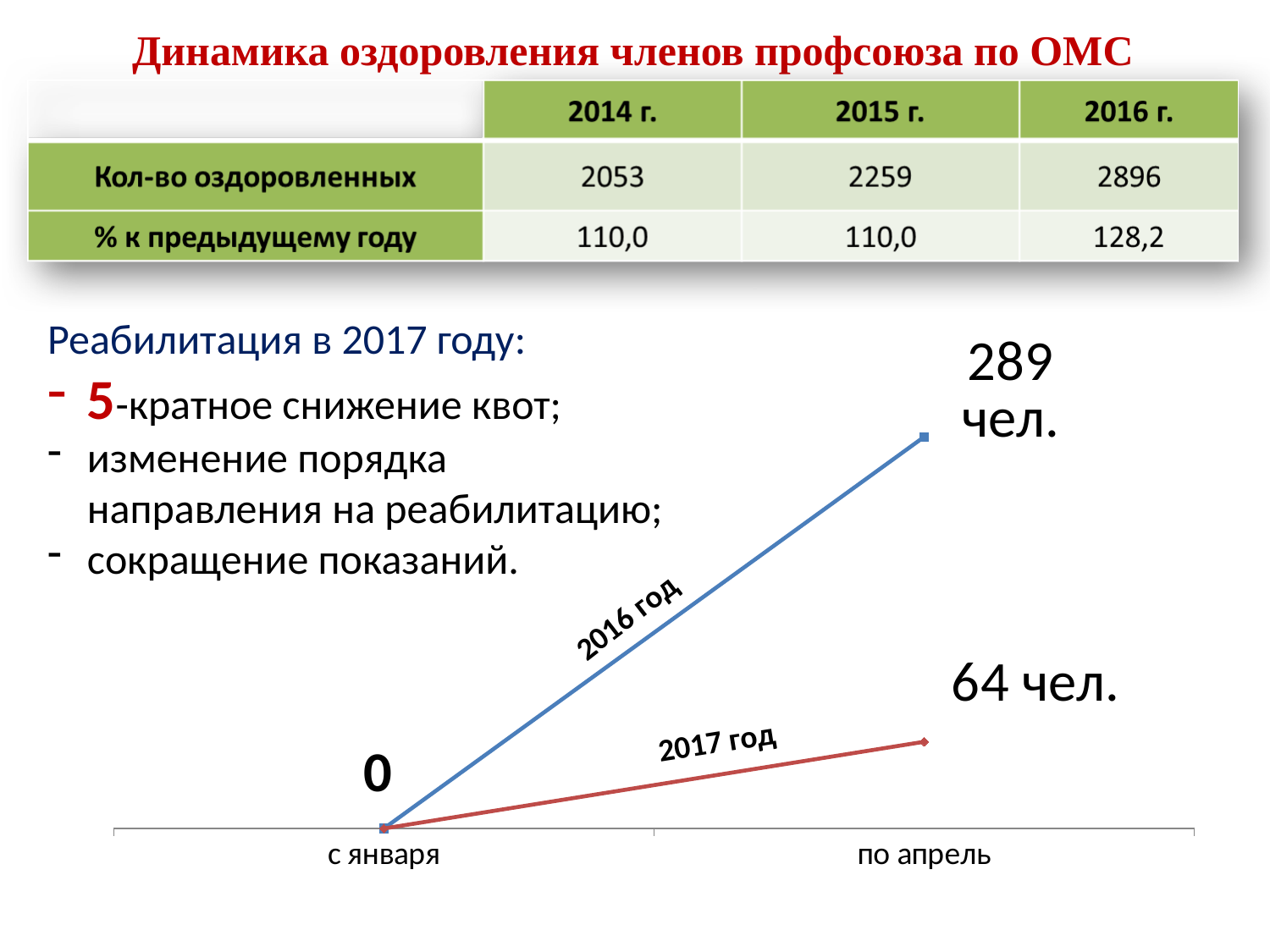
What are the two x-axis labels of the line chart? с января, по апрель In the line chart, do the values rise or fall from "с января" to "по апрель"? rise What kind of chart is shown at the bottom of the slide? line chart Which series in the line chart reaches the highest value? 2016 год In the line chart, which series has the larger value at "по апрель", 2016 год or 2017 год? 2016 год In the line chart, what is the difference between the 2016 год and 2017 год values at "по апрель"? 225 In the line chart, what value do both lines start from at "с января"? 0 In the line chart, what value does the 2016 год line reach at "по апрель"? 289 чел. In the line chart, what value does the 2017 год line reach at "по апрель"? 64 чел. What colour is the 2017 год line in the chart? red How many series are plotted in the line chart? 2 How many categories are shown on the x axis of the line chart? 2